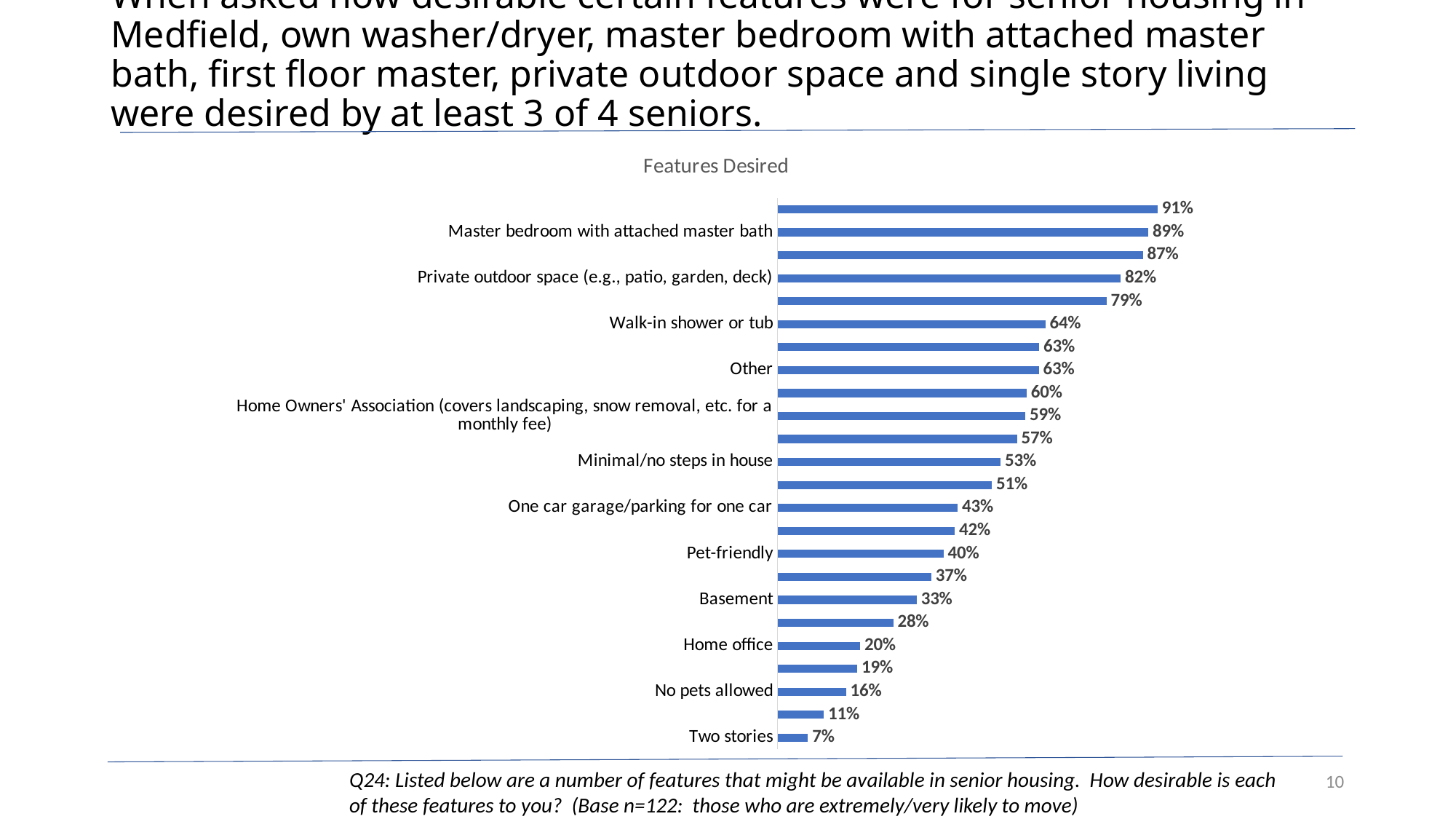
What is the value for Two stories? 7% What kind of chart is shown on the slide? bar chart What is the difference between the values for Pet-friendly and No pets allowed? 24% What is the value for Home Owners' Association (covers landscaping, snow removal, etc. for a monthly fee)? 59% What is the value for Walk-in shower or tub? 64% What is the highest value shown on any bar in the chart? 91% Which labeled feature has the lowest value in the chart? Two stories What percentage of seniors desired a master bedroom with attached master bath? 89% What is the title of the chart? Features Desired Which has a larger value, Basement or Home office? Basement What is the value for Private outdoor space (e.g., patio, garden, deck)? 82% How many bars are plotted in the chart? 24